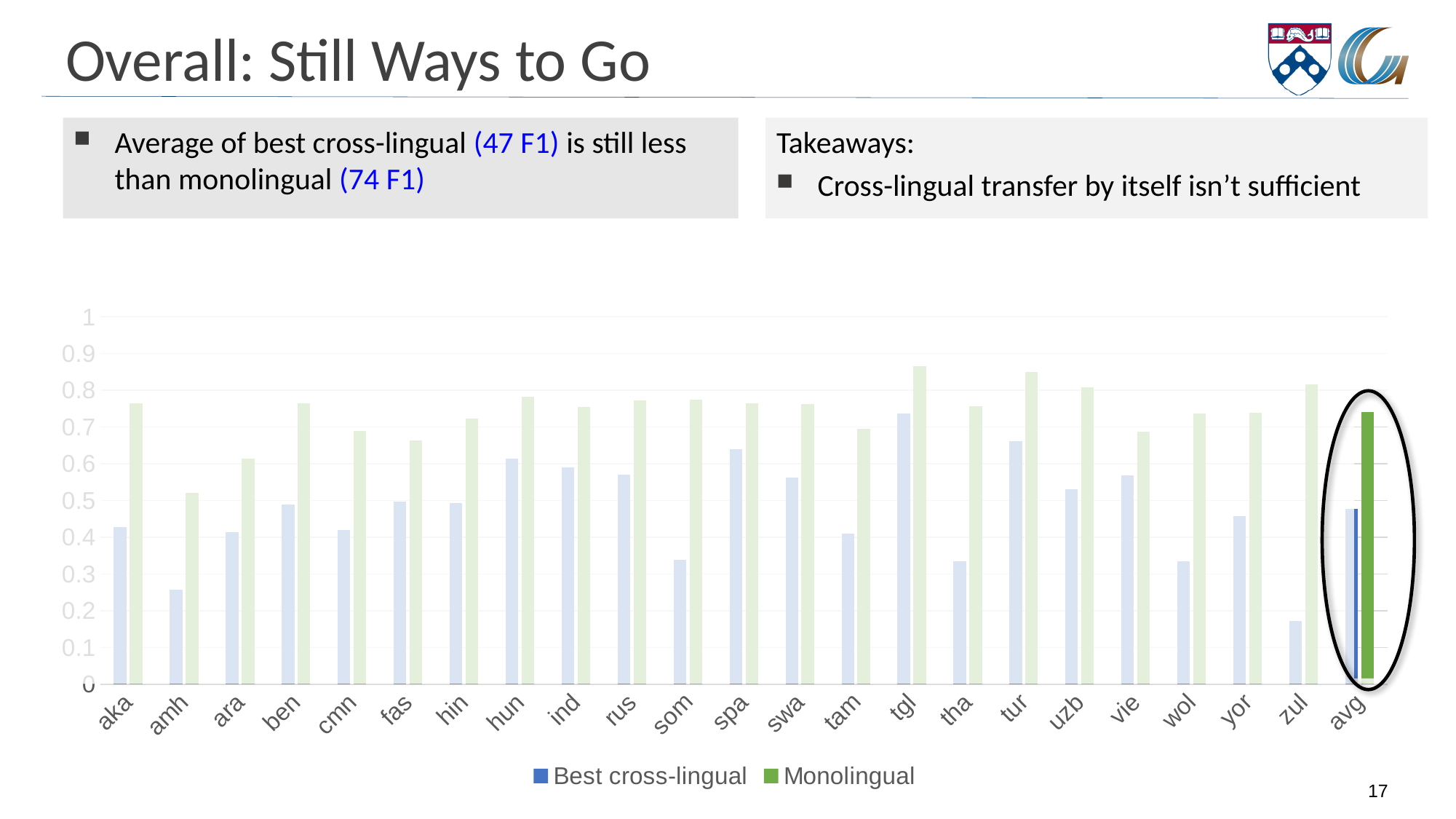
How many series does the chart legend list? 2 Is the Best cross-lingual value for zul greater or less than 0.2? less Is the Monolingual value for tgl greater or less than 0.8? greater Which category has the highest Best cross-lingual value? tgl How many categories are shown along the x axis of the chart? 23 Is the Best cross-lingual value for som greater or less than 0.4? less What are the two series named in the chart legend? Best cross-lingual and Monolingual For the category avg, which series has the larger value, Best cross-lingual or Monolingual? Monolingual Which category has the lowest Best cross-lingual value? zul Which category has the lowest Monolingual value? amh What kind of chart is shown on the slide? bar chart Which category on the x axis is circled on the chart? avg